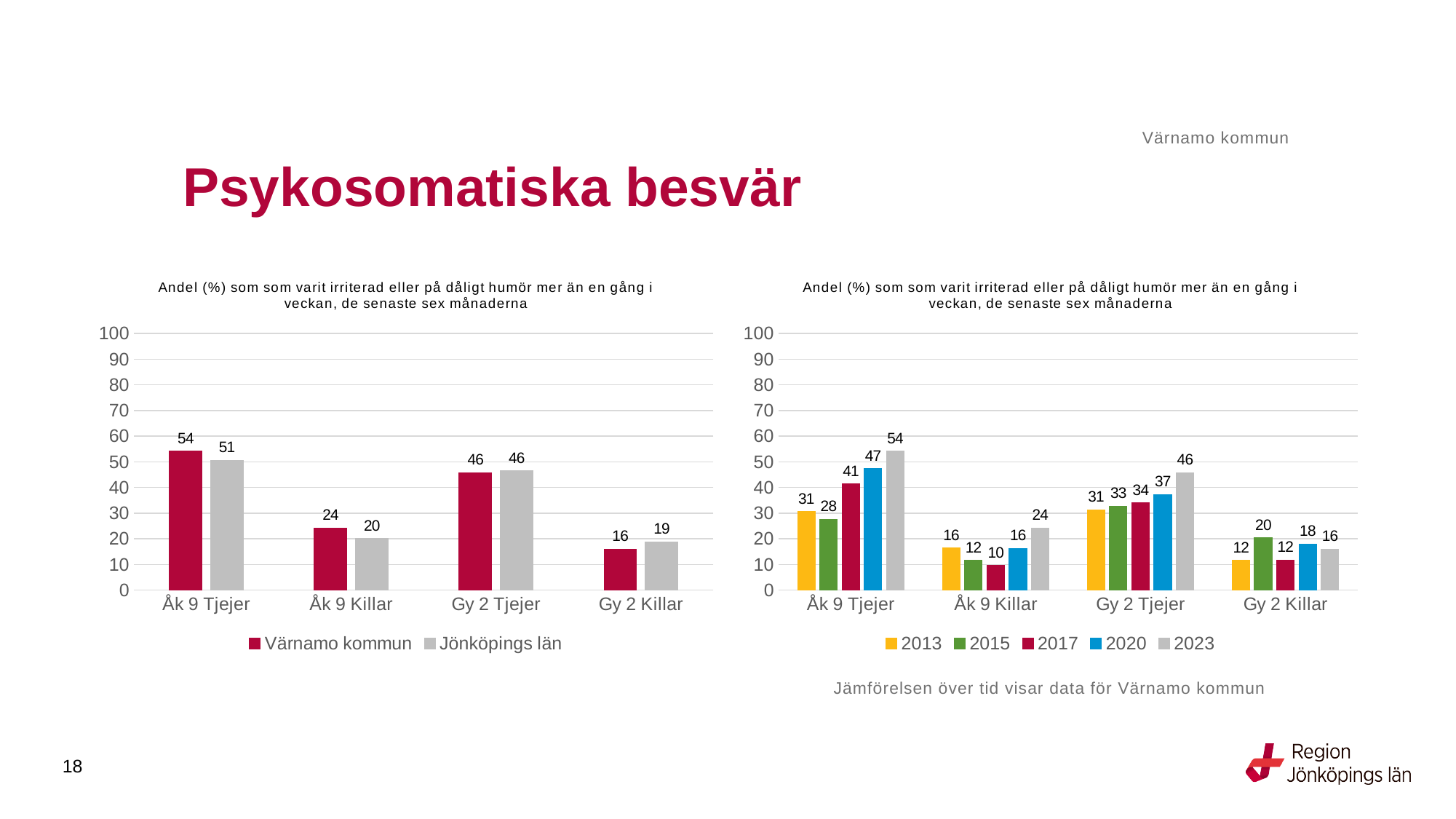
In the left chart, how many series does the legend list? 2 In the left chart, what is the difference between Värnamo kommun and Jönköpings län for Åk 9 Killar? 4 In the right chart, which year has the highest value for Åk 9 Tjejer? 2023 In the left chart, which category has the lowest value for Värnamo kommun? Gy 2 Killar What type of chart is the left chart? Bar chart In the right chart, what is the difference between the 2023 and 2013 values for Gy 2 Tjejer? 15 In the right chart, what is the value for 2020 for Gy 2 Tjejer? 37 In the right chart, how many series does the legend list? 5 In the left chart, what is the value for Jönköpings län for Gy 2 Killar? 19 In the right chart, is the value for 2015 for Gy 2 Killar larger or smaller than the value for 2013 for Gy 2 Killar? larger In the right chart, what is the value for 2017 for Åk 9 Killar? 10 In the left chart, what is the value for Värnamo kommun for Åk 9 Tjejer? 54